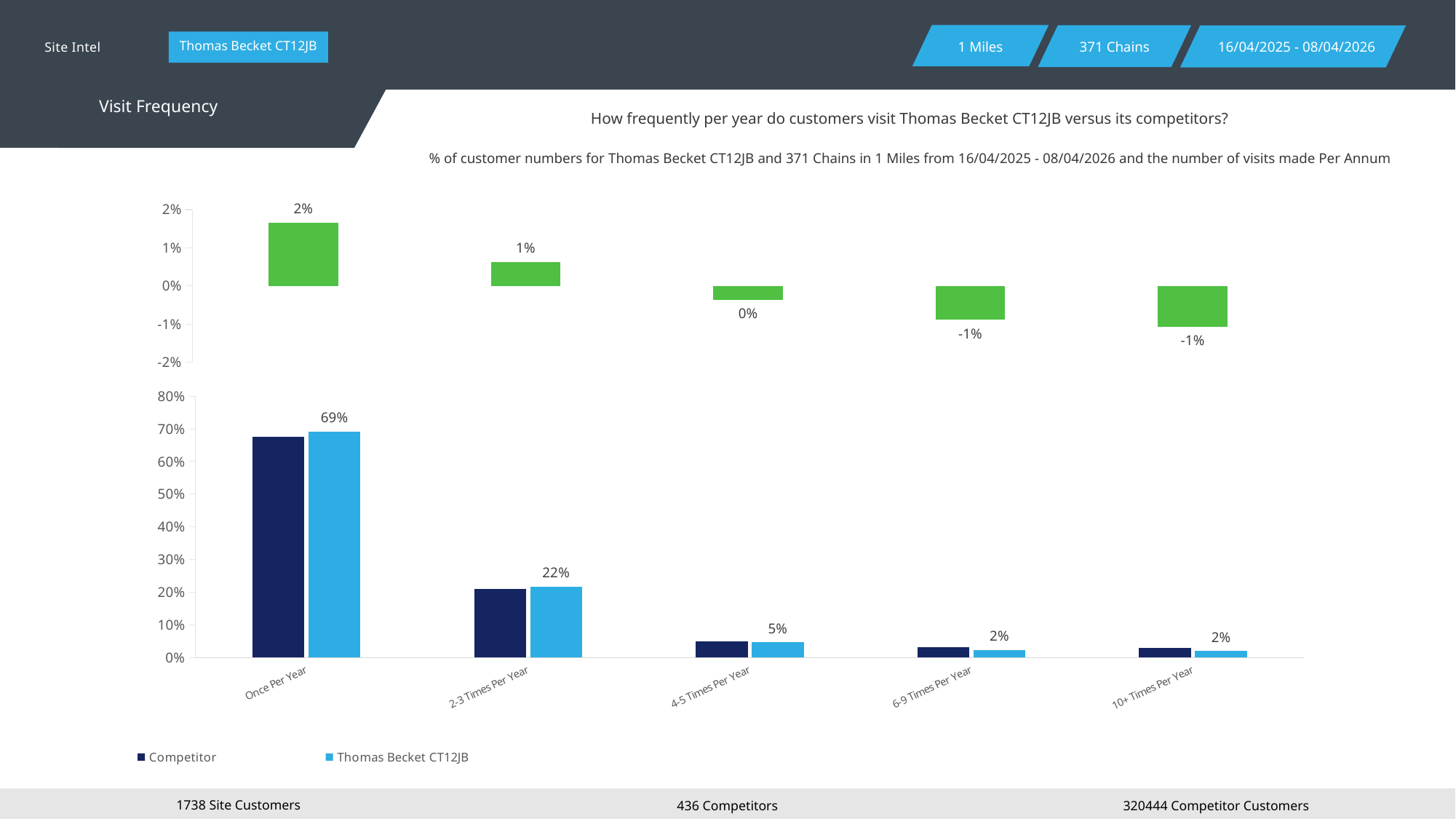
In the bottom bar chart, is the Competitor value for Once Per Year greater or less than 60%? greater In the bottom bar chart, what is the value for Thomas Becket CT12JB in the Once Per Year category? 69% In the bottom bar chart, is the Competitor value for 2-3 Times Per Year greater or less than 30%? less In the bottom bar chart, what is the difference between the Thomas Becket CT12JB values for Once Per Year and 2-3 Times Per Year? 47 percentage points In the bottom bar chart, what is the value for Thomas Becket CT12JB in the 4-5 Times Per Year category? 5% What kind of chart is the bottom chart on the slide? bar chart In the bottom bar chart, what is the value for Thomas Becket CT12JB in the 2-3 Times Per Year category? 22% In the top green bar chart, what is the value for the Once Per Year category? 2% How many visit frequency categories are shown on the x axis of the bottom bar chart? 5 In the bottom bar chart, which category has the highest value for Thomas Becket CT12JB? Once Per Year In the bottom bar chart, do the Thomas Becket CT12JB values rise or fall from Once Per Year to 10+ Times Per Year? fall How many series does the legend of the bottom bar chart list? 2